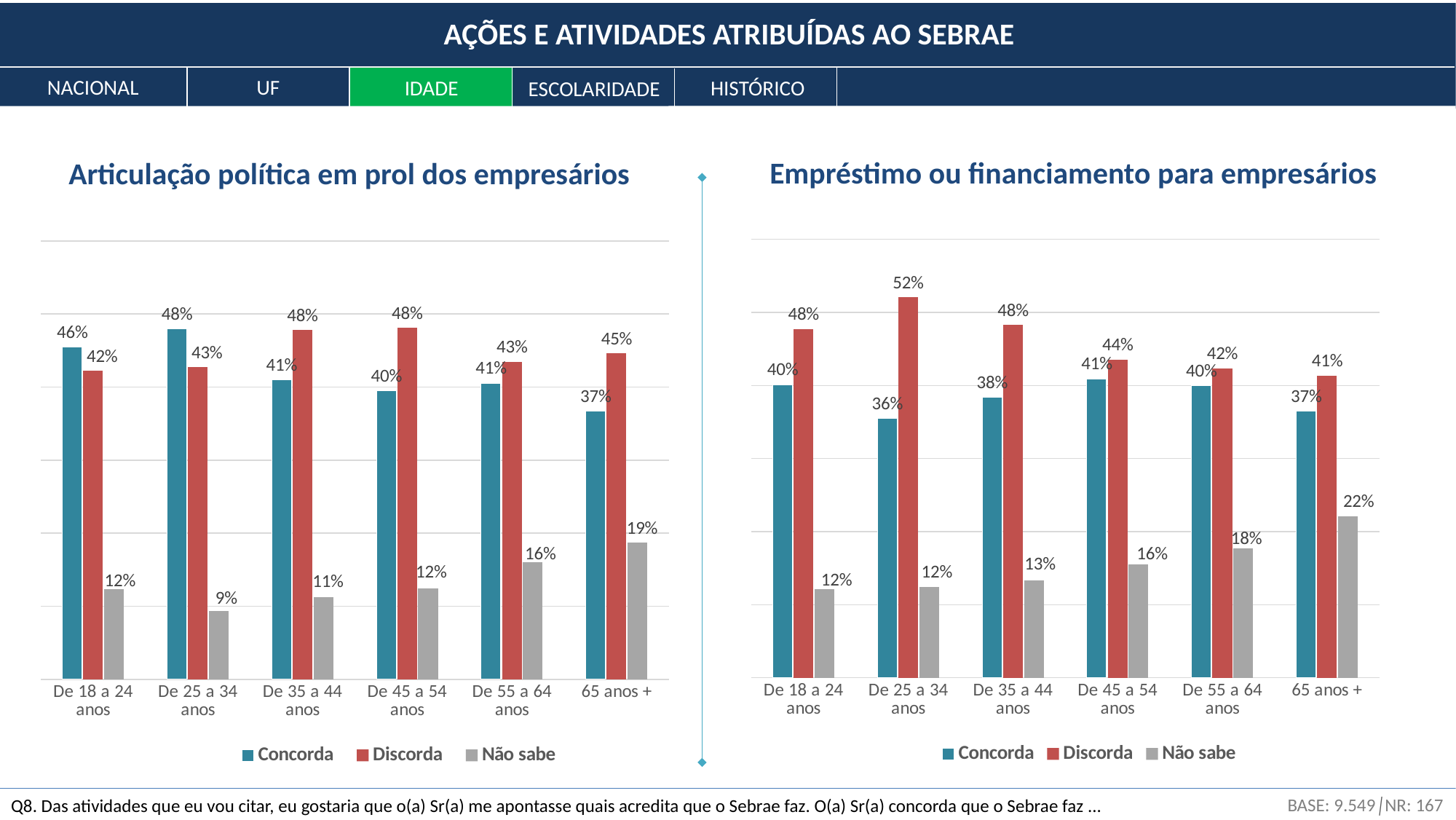
In the chart 'Empréstimo ou financiamento para empresários', which age group has the lowest Concorda value? De 25 a 34 anos In the chart 'Empréstimo ou financiamento para empresários', which is larger for 'De 45 a 54 anos': Concorda or Discorda? Discorda How many age groups are shown on the x axis of the chart 'Empréstimo ou financiamento para empresários'? 6 How many series does the legend of the chart 'Articulação política em prol dos empresários' list? 3 In the chart 'Empréstimo ou financiamento para empresários', what is the difference between Discorda and Concorda for 'De 25 a 34 anos'? 16% In the chart 'Empréstimo ou financiamento para empresários', what is the Não sabe value for '65 anos +'? 22% In the chart 'Articulação política em prol dos empresários', what is the Não sabe value for 'De 25 a 34 anos'? 9% In the chart 'Articulação política em prol dos empresários', what is the difference between Discorda and Concorda for '65 anos +'? 8% In the chart 'Articulação política em prol dos empresários', which age group has the highest Não sabe value? 65 anos + In the chart 'Empréstimo ou financiamento para empresários', what is the Discorda value for 'De 25 a 34 anos'? 52% In the chart 'Articulação política em prol dos empresários', what is the Concorda value for 'De 18 a 24 anos'? 46% In the chart 'Articulação política em prol dos empresários', which age group has the lowest Concorda value? 65 anos +